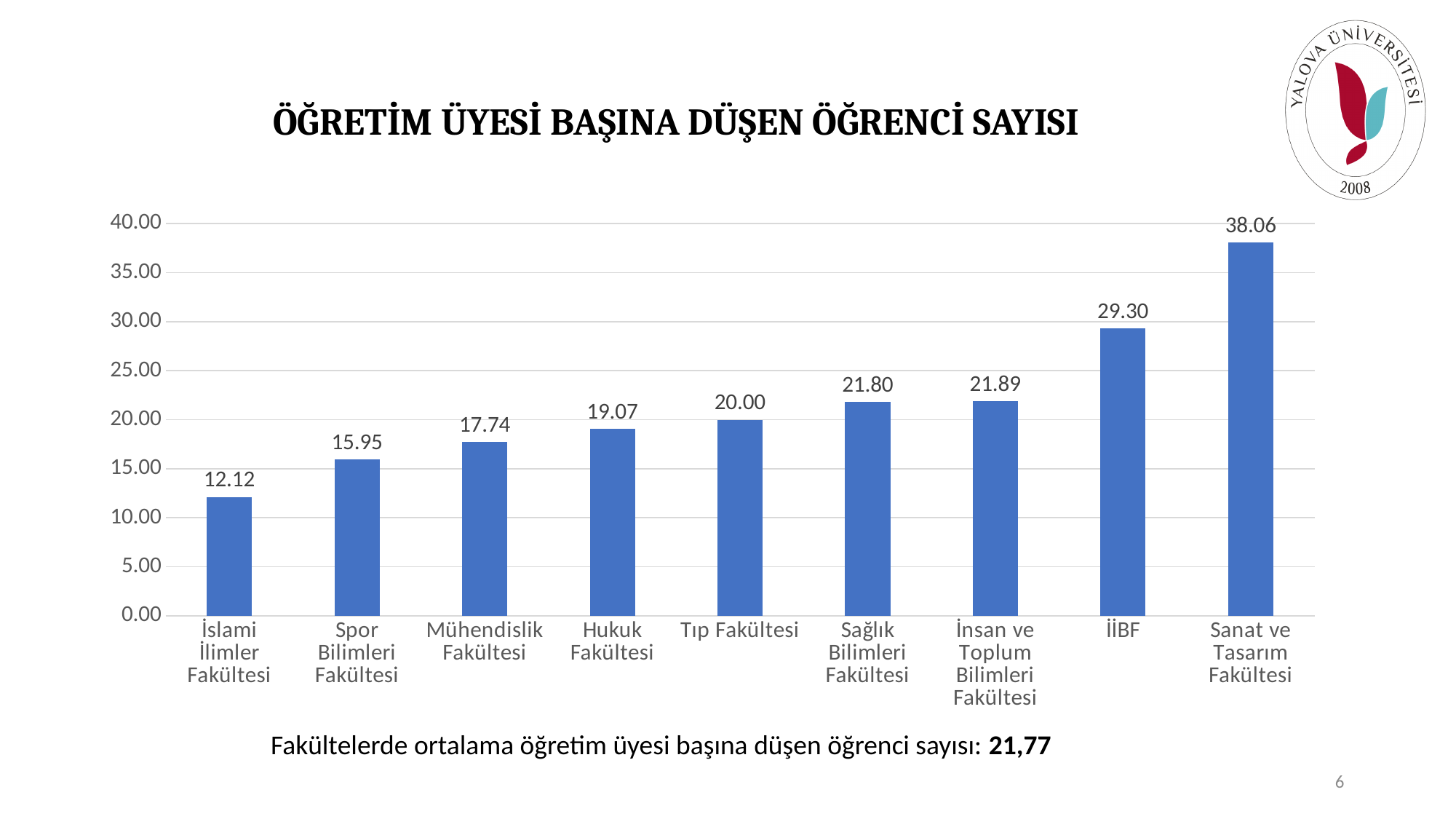
Which faculty has the highest number of students per faculty member? Sanat ve Tasarım Fakültesi Is the value for İİBF greater or less than 25.00? greater What kind of chart is shown on the slide? Bar chart What value is shown for İİBF? 29.30 What is the difference between the values for Sanat ve Tasarım Fakültesi and İİBF? 8.76 What is the difference between the values for Mühendislik Fakültesi and Spor Bilimleri Fakültesi? 1.79 Do the values rise or fall from left to right across the chart? Rise How many faculties are shown on the chart? 9 What value is shown for Sanat ve Tasarım Fakültesi? 38.06 What is the number of students per faculty member for Hukuk Fakültesi? 19.07 Which is larger, the value for Tıp Fakültesi or the value for Hukuk Fakültesi? Tıp Fakültesi Which faculty has the lowest number of students per faculty member? İslami İlimler Fakültesi